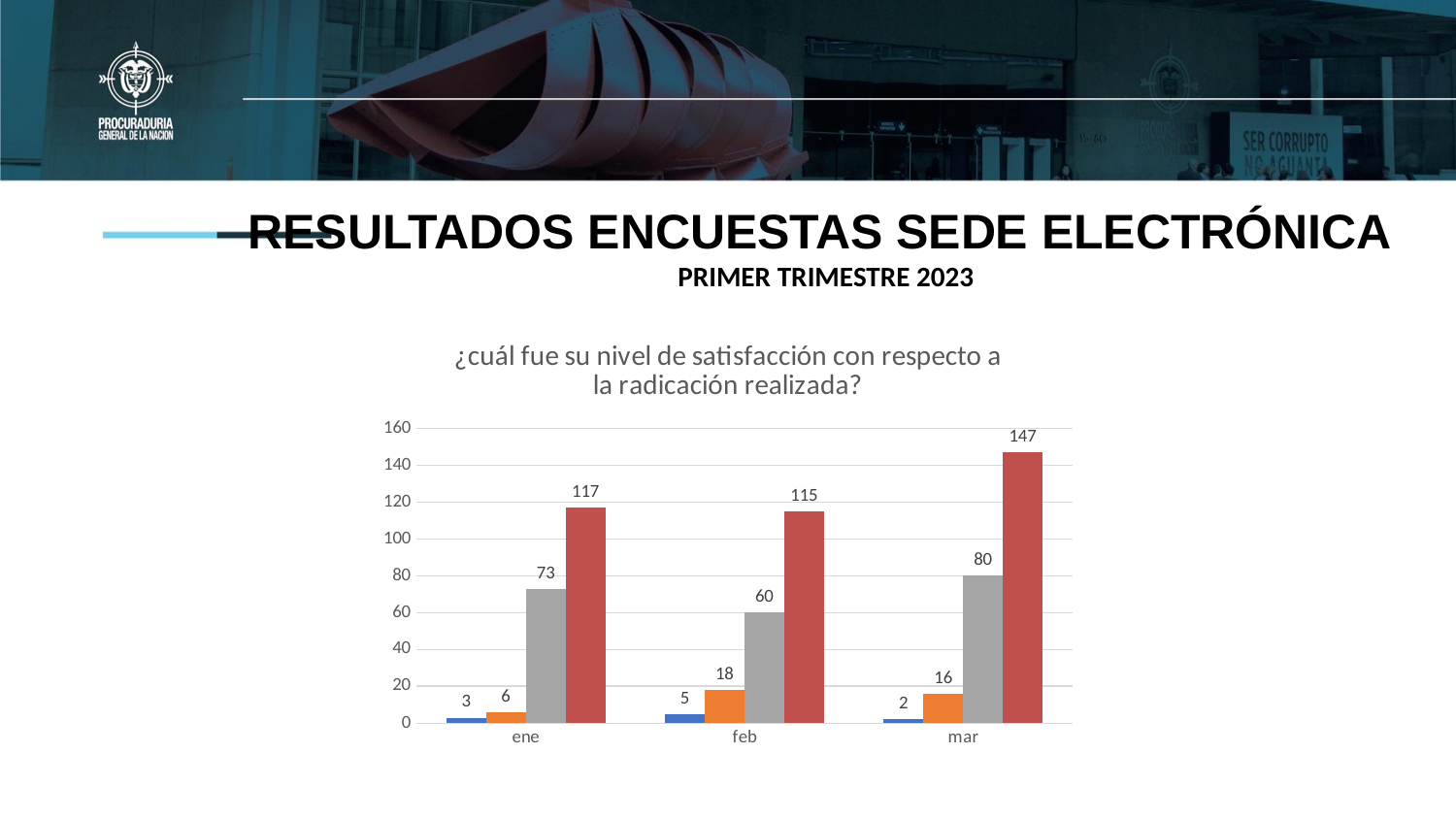
Which month has the highest red bar? mar What is the title of the chart? ¿cuál fue su nivel de satisfacción con respecto a la radicación realizada? Which is larger, the grey bar for ene or the grey bar for feb? ene What kind of chart is shown on the slide? bar chart What is the difference between the red bar for mar and the red bar for feb? 32 What is the value of the red bar for mar? 147 What is the value of the blue bar for mar? 2 Which month has the lowest blue bar? mar What is the value of the grey bar for ene? 73 Is the value of the grey bar for mar greater or less than 100? less How many months are shown on the x axis? 3 What is the value of the orange bar for feb? 18